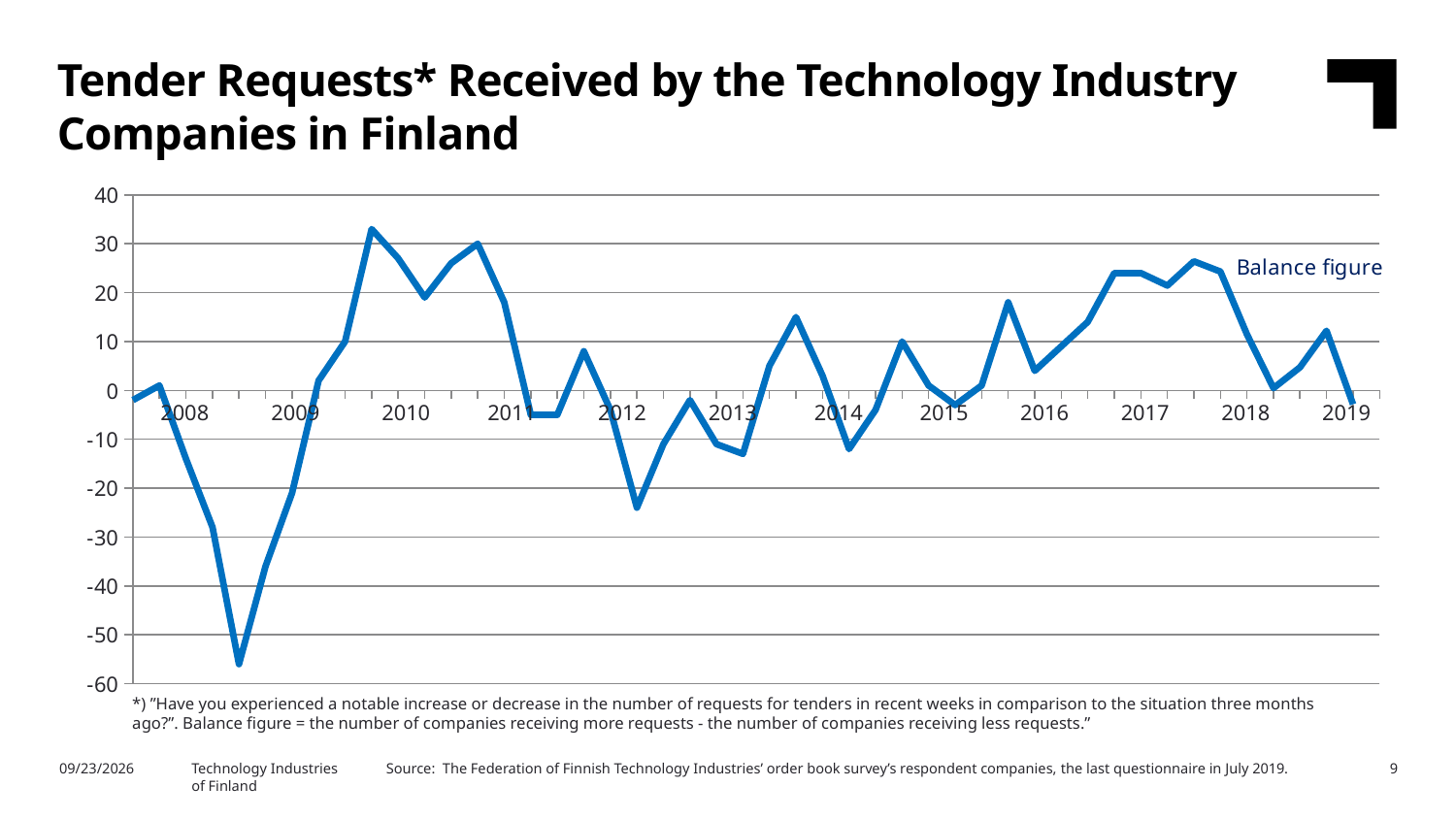
Does the balance figure rise or fall between 2008 and 2009? fall How many year labels are shown on the x axis of the chart? 12 Is the lowest value of the balance figure greater or less than -50? less What kind of chart is shown on the slide? line chart In which year does the balance figure reach its lowest point? 2009 What is the title of the chart on the slide? Tender Requests* Received by the Technology Industry Companies in Finland Is the highest value of the balance figure greater or less than 20? greater Does the balance figure rise or fall overall from 2017 to 2019? fall Does the balance figure rise or fall between 2009 and 2010? rise Is the balance figure at the 2019 end of the line greater or less than 10? less